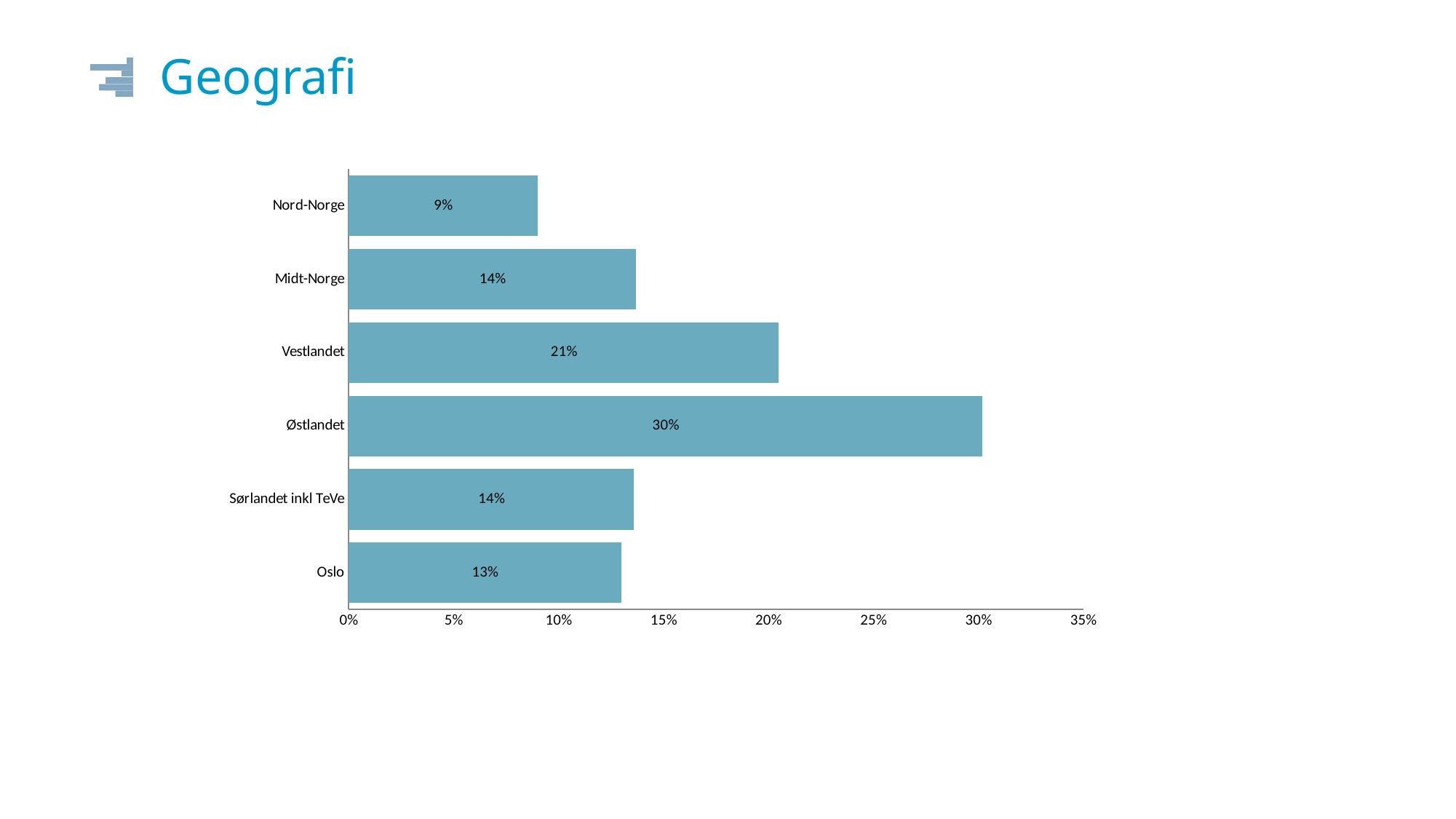
What is the difference between the values for Østlandet and Vestlandet? 9% What is the value for Oslo? 13% Which region has the lowest value? Nord-Norge What is the difference between the values for Midt-Norge and Nord-Norge? 5% What is the value for Vestlandet? 21% How many regions are shown in the chart? 6 Which is larger, the value for Vestlandet or the value for Oslo? Vestlandet What is the value for Østlandet? 30% What is the value for Nord-Norge? 9% What kind of chart is shown on the slide? Bar chart Which region has the highest value? Østlandet Is the value for Østlandet greater or less than 25%? greater